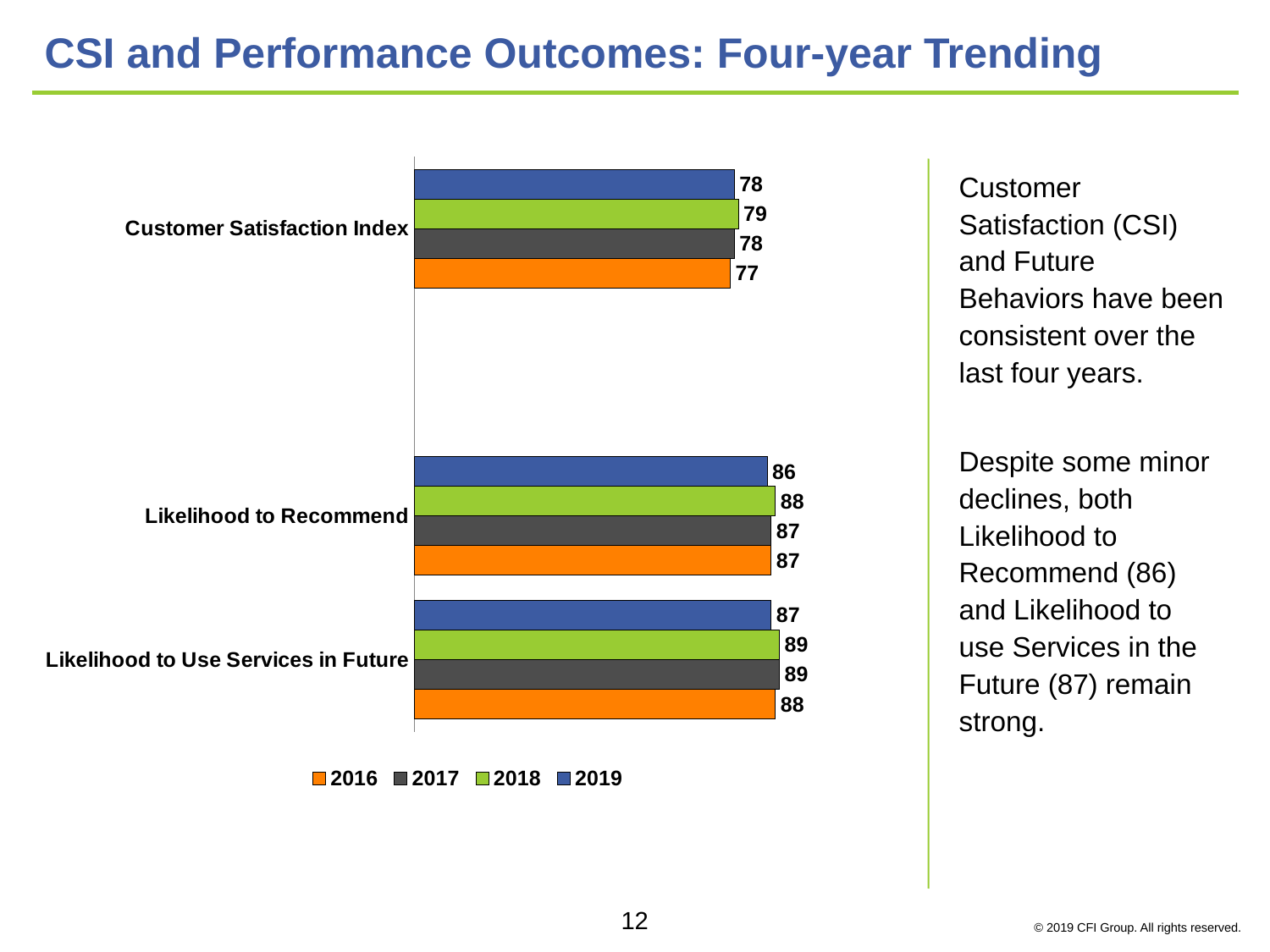
What is the Customer Satisfaction Index value for 2019? 78 Which is larger for 2019: Likelihood to Recommend or Likelihood to Use Services in Future? Likelihood to Use Services in Future Which year has the lowest Likelihood to Recommend value? 2019 What is the Likelihood to Recommend value for 2018? 88 Which year has the highest Customer Satisfaction Index value? 2018 How many series does the legend list? 4 What is the Customer Satisfaction Index value for 2016? 77 What kind of chart is shown on the slide? Bar chart What is the difference between the 2018 and 2019 values for Likelihood to Use Services in Future? 2 How many categories are shown on the chart? 3 Which colour represents 2016 in the legend? Orange What is the Likelihood to Use Services in Future value for 2016? 88